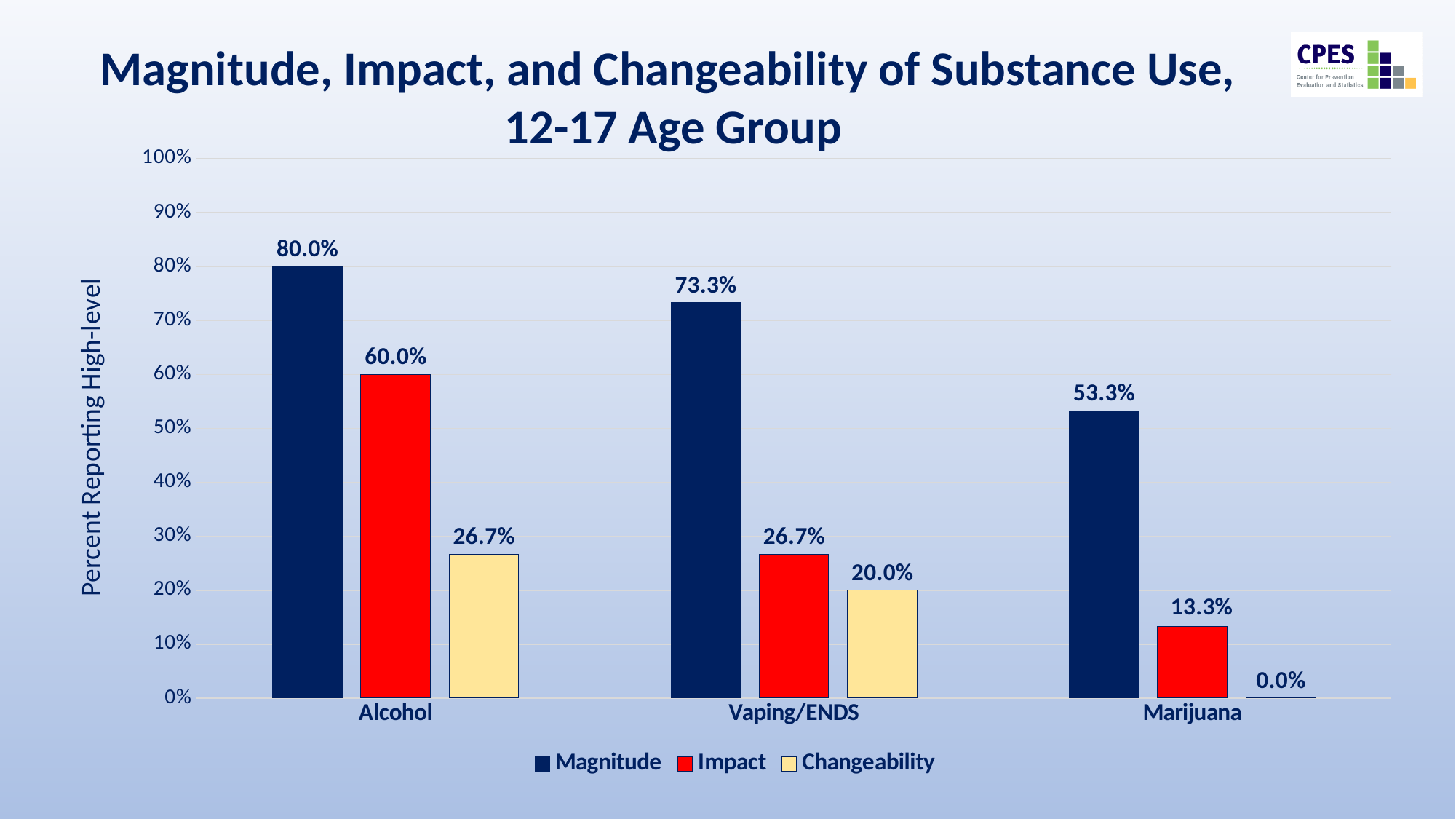
What is the label of the y axis? Percent Reporting High-level Which category has the highest Magnitude value? Alcohol Do the Magnitude values rise or fall from Alcohol to Marijuana along the x axis? Fall What is the difference between the Magnitude and Impact values for Alcohol? 20.0% Which is larger, the Impact value for Alcohol or the Magnitude value for Marijuana? Impact value for Alcohol What is the Changeability value for Marijuana? 0.0% What kind of chart is shown on the slide? Bar chart Which category has the lowest Impact value? Marijuana What is the Impact value for Vaping/ENDS? 26.7% What is the Magnitude value for Alcohol? 80.0% How many categories are shown on the x axis? 3 How many series does the legend list? 3